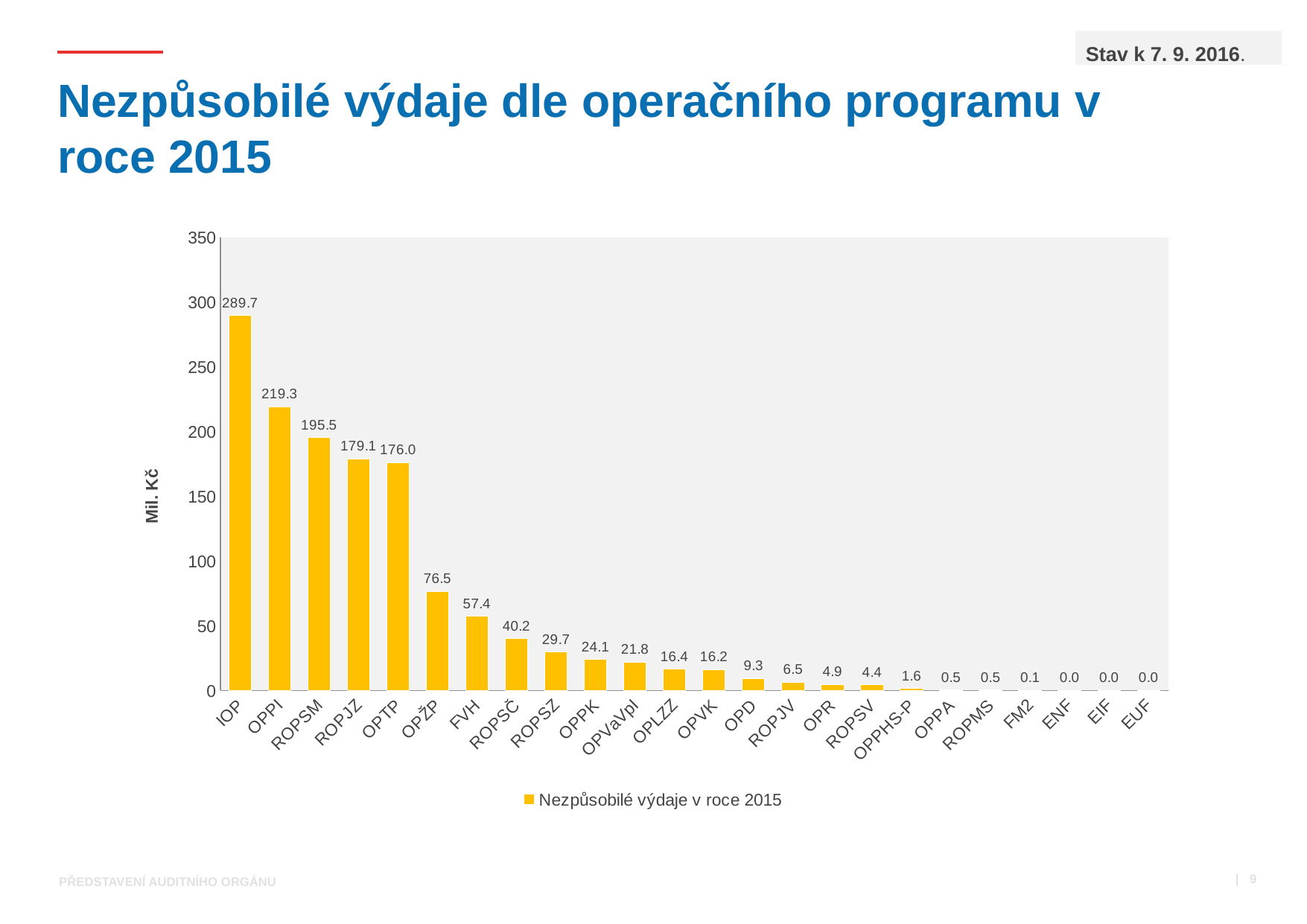
How many series does the legend list? 1 Which operational programme has the highest value? IOP What is the value for IOP? 289.7 What unit is shown on the y axis label? Mil. Kč What is the value for ROPSV? 4.4 What is the value for OPŽP? 76.5 What kind of chart is shown on the slide? bar chart Which is larger, the value for FVH or the value for ROPSČ? FVH What is the difference between the values for ROPJZ and OPTP? 3.1 What is the value for OPVK? 16.2 How many operational programmes are shown on the x axis? 24 What is the difference between the values for IOP and OPPI? 70.4